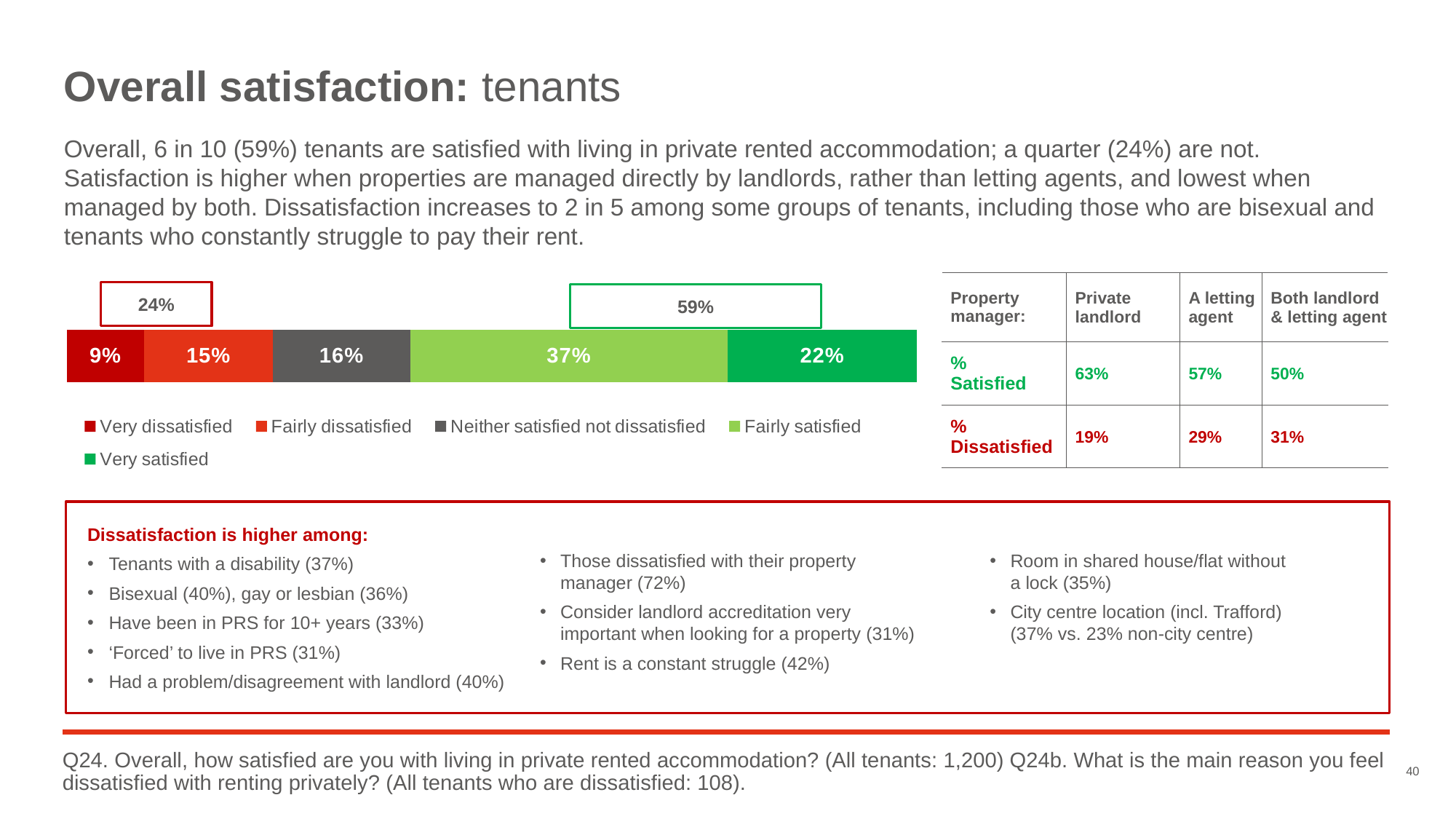
What is the difference between the fairly satisfied and very satisfied percentages? 15% How many series does the legend list? 5 Which response category has the smallest share of tenants? Very dissatisfied What is the combined percentage of tenants who are dissatisfied (very or fairly)? 24% What percentage of tenants are fairly satisfied? 37% What colour is the very satisfied segment of the bar? Dark green Which response category has the largest share of tenants? Fairly satisfied What kind of chart is shown? Stacked bar chart What percentage of tenants are very satisfied? 22% What percentage of tenants are neither satisfied nor dissatisfied? 16% Which is larger, the fairly dissatisfied share or the neither satisfied nor dissatisfied share? Neither satisfied not dissatisfied What percentage of tenants are very dissatisfied? 9%